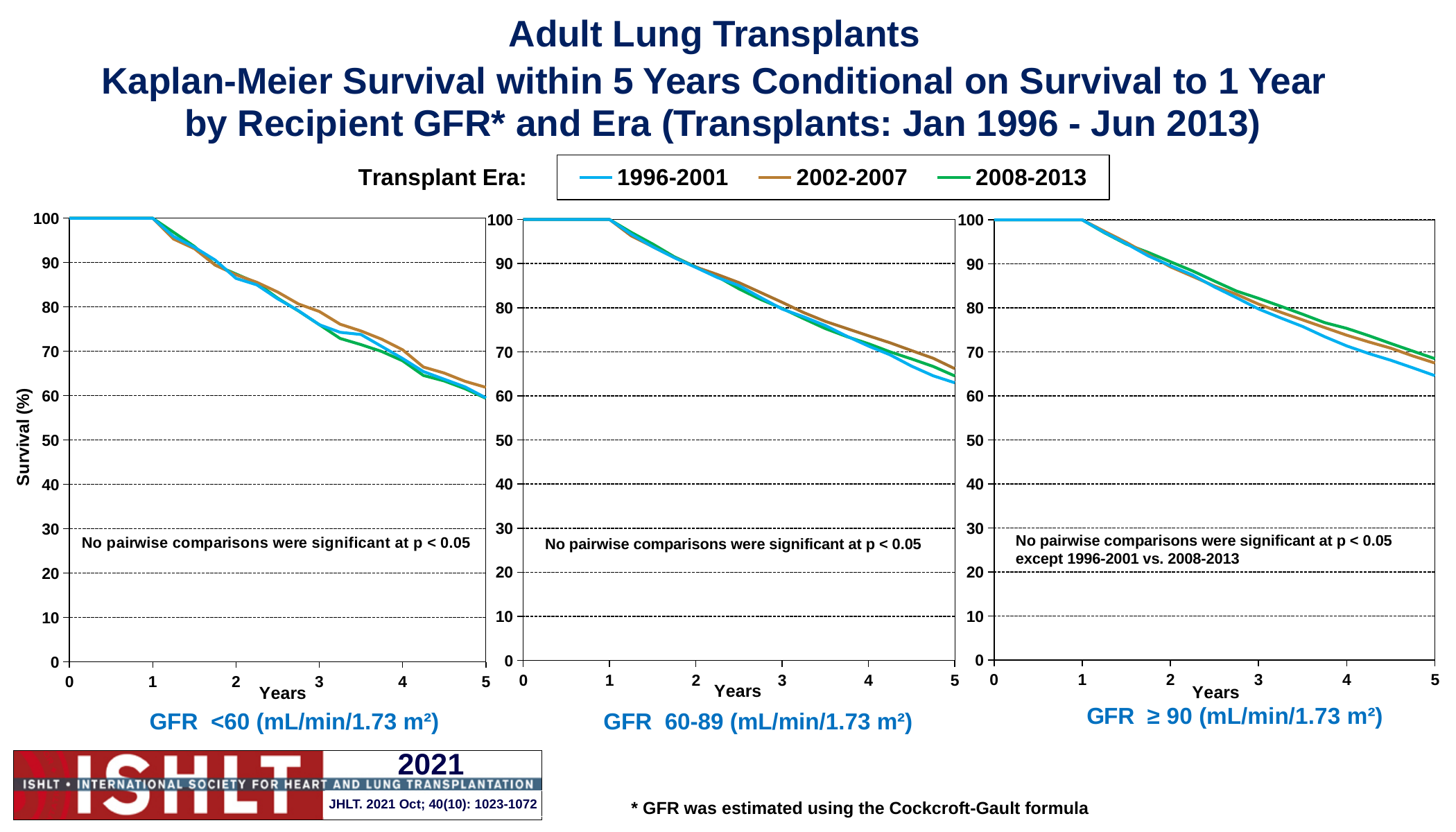
Which transplant era is drawn in green in the legend? 2008-2013 How many transplant eras does the legend list? 3 In the GFR ≥ 90 chart, is the survival value for the 1996-2001 era at year 5 greater or less than 70? less How many charts are shown on the slide? 3 In the GFR <60 chart, what is the survival value for the 1996-2001 era at year 1? 100 In the GFR ≥ 90 chart, do the survival curves rise or fall as years increase from 1 to 5? fall In the GFR 60-89 chart, is the survival value for the 2002-2007 era at year 3 greater or less than 80? greater In the GFR <60 chart, is the survival value for the 1996-2001 era at year 5 greater or less than 70? less What is the label of the y axis on the leftmost chart? Survival (%) What kind of chart is used in each of the three panels on the slide? line chart In the GFR ≥ 90 chart, which era has the higher survival at year 5: 2008-2013 or 1996-2001? 2008-2013 In the GFR <60 chart, which era has the higher survival at year 3: 2002-2007 or 1996-2001? 2002-2007